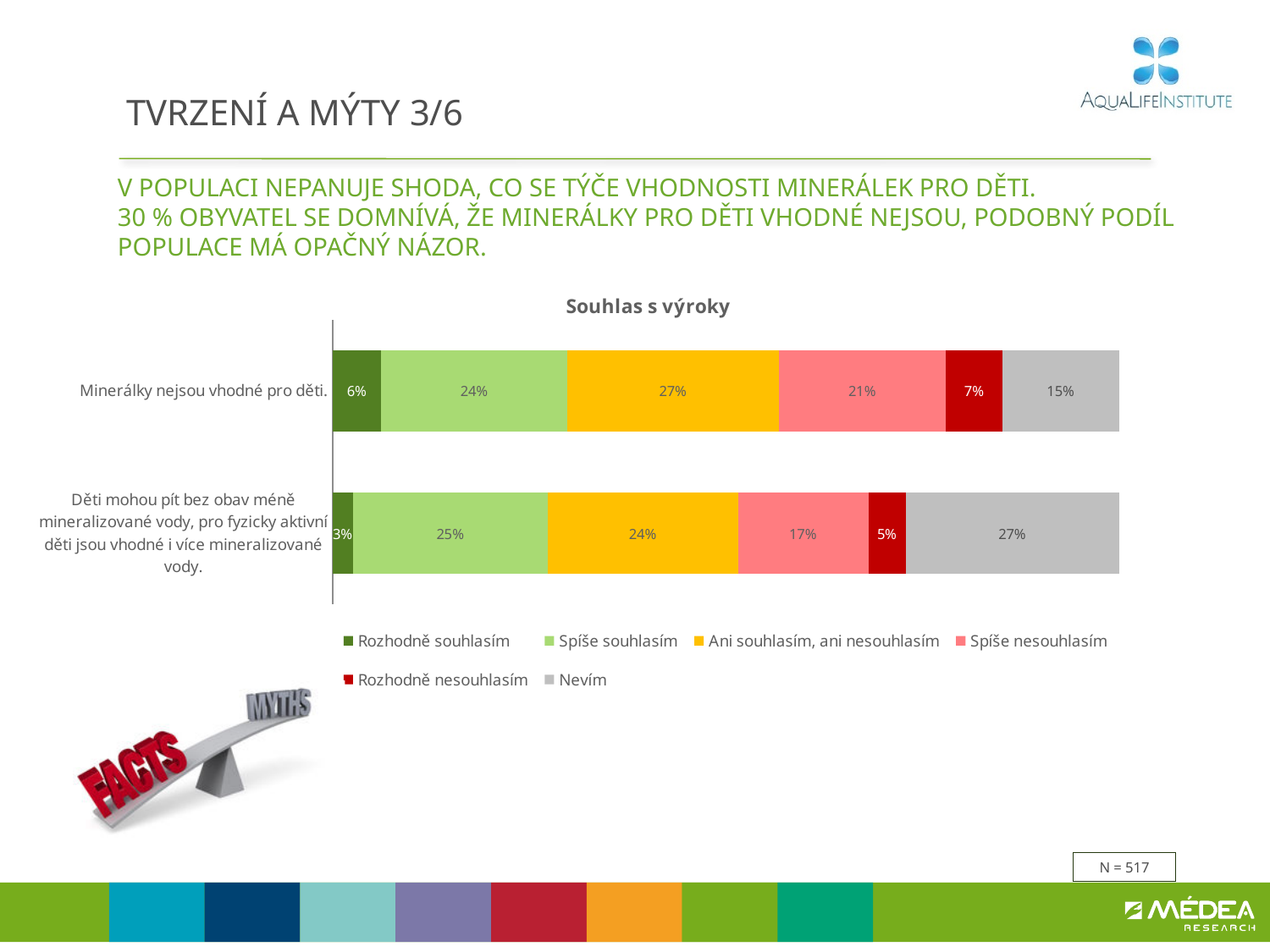
What is the value of "Nevím" for the statement "Děti mohou pít bez obav méně mineralizované vody, pro fyzicky aktivní děti jsou vhodné i více mineralizované vody."? 27% Which response has the highest share for the statement "Minerálky nejsou vhodné pro děti."? Ani souhlasím, ani nesouhlasím Which response has the lowest share for the statement "Děti mohou pít bez obav méně mineralizované vody..."? Rozhodně souhlasím Which statement has the larger "Rozhodně nesouhlasím" share? Minerálky nejsou vhodné pro děti. What is the value of "Spíše nesouhlasím" for the statement "Děti mohou pít bez obav méně mineralizované vody..."? 17% What is the value of "Ani souhlasím, ani nesouhlasím" for the statement "Minerálky nejsou vhodné pro děti."? 27% What is the difference between the "Nevím" values for the two statements? 12 percentage points How many statements (categories) are plotted in the chart? 2 How many series does the legend list? 6 What is the title of the chart? Souhlas s výroky What kind of chart is shown on the slide? Stacked bar chart What is the value of "Rozhodně souhlasím" for the statement "Minerálky nejsou vhodné pro děti."? 6%